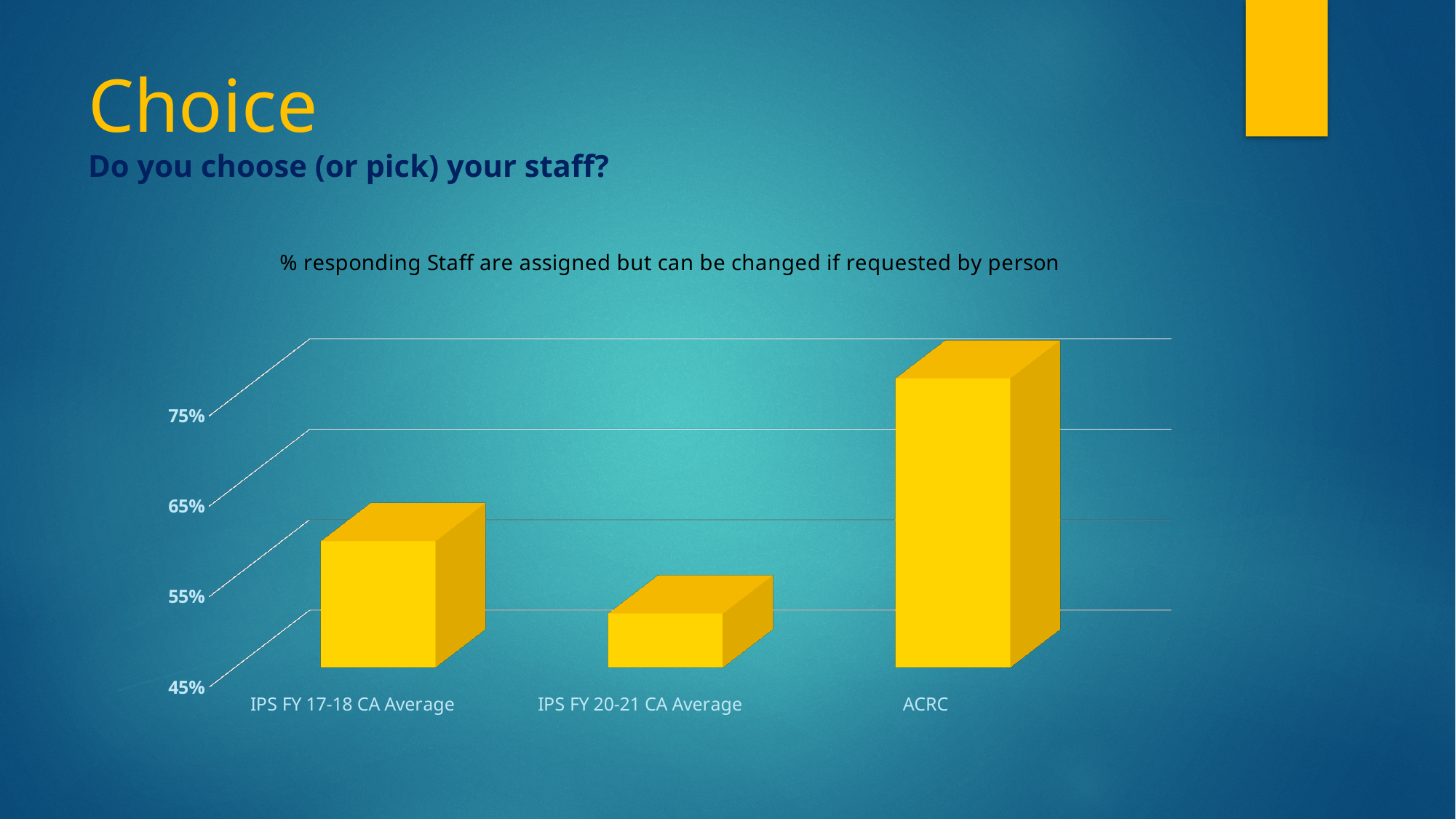
What is the title of the chart? % responding Staff are assigned but can be changed if requested by person Does the value rise or fall from IPS FY 17-18 CA Average to IPS FY 20-21 CA Average? fall Which category has the highest value? ACRC Which is larger, the value for ACRC or the value for IPS FY 17-18 CA Average? ACRC Is the value for IPS FY 17-18 CA Average greater or less than 55%? greater Which is larger, the value for IPS FY 17-18 CA Average or the value for IPS FY 20-21 CA Average? IPS FY 17-18 CA Average Is the value for IPS FY 20-21 CA Average greater or less than 65%? less How many categories are plotted in the chart? 3 Is the value for ACRC greater or less than 65%? greater Which category has the lowest value? IPS FY 20-21 CA Average What kind of chart is shown on the slide? Bar chart